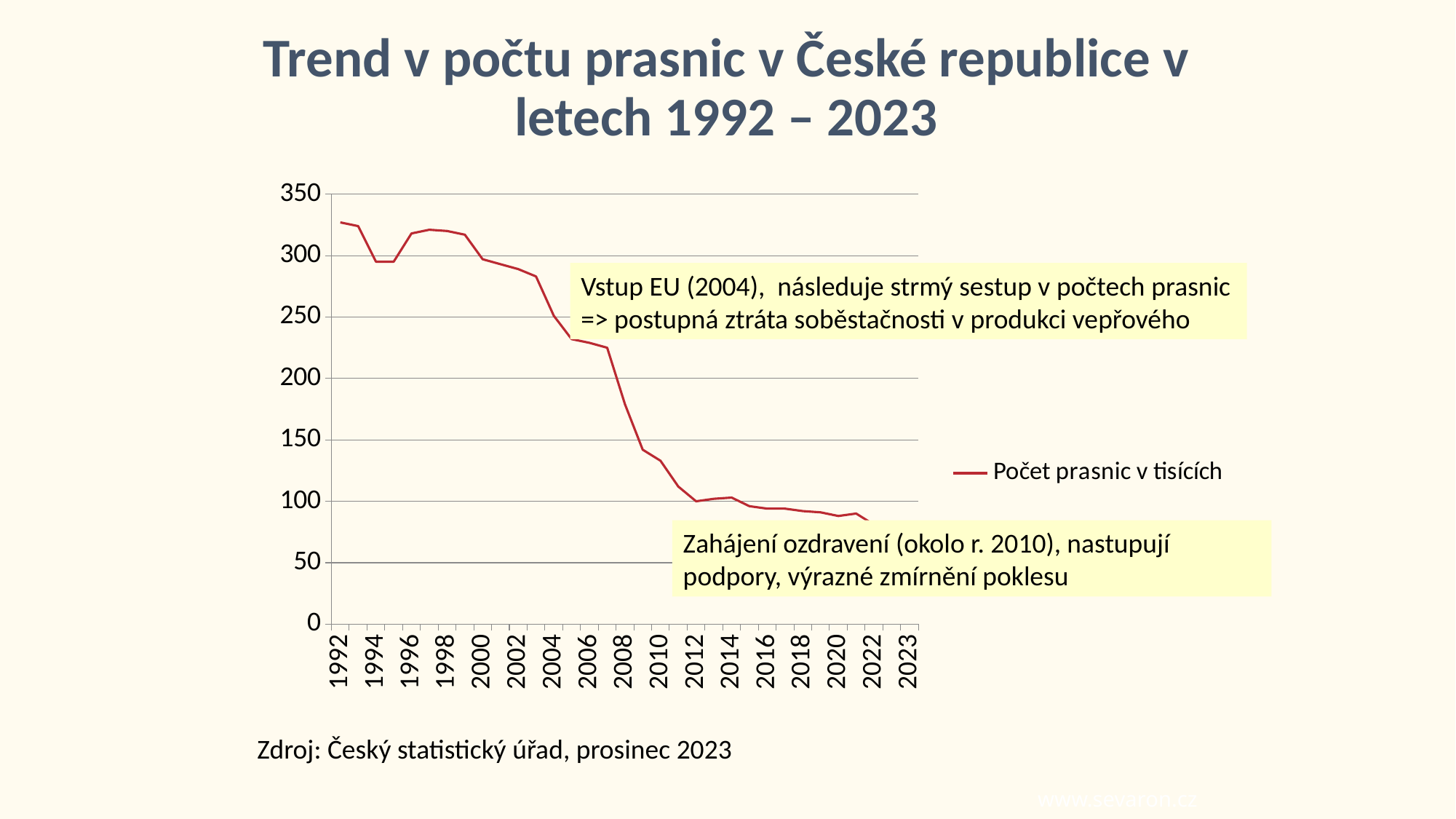
How many series does the legend list? 1 Do the values rise or fall along the x axis from 1992 to 2023? fall Is the value for 2012 greater or less than 150? less Is the value for 1992 greater or less than 300? greater What is the title of the slide? Trend v počtu prasnic v České republice v letech 1992 – 2023 What is the legend entry for the plotted series? Počet prasnic v tisících Which is larger, the value for 1992 or the value for 2022? 1992 Is the value for 2007 greater or less than 200? greater What kind of chart is shown on the slide? line chart Which is larger, the value for 2000 or the value for 2010? 2000